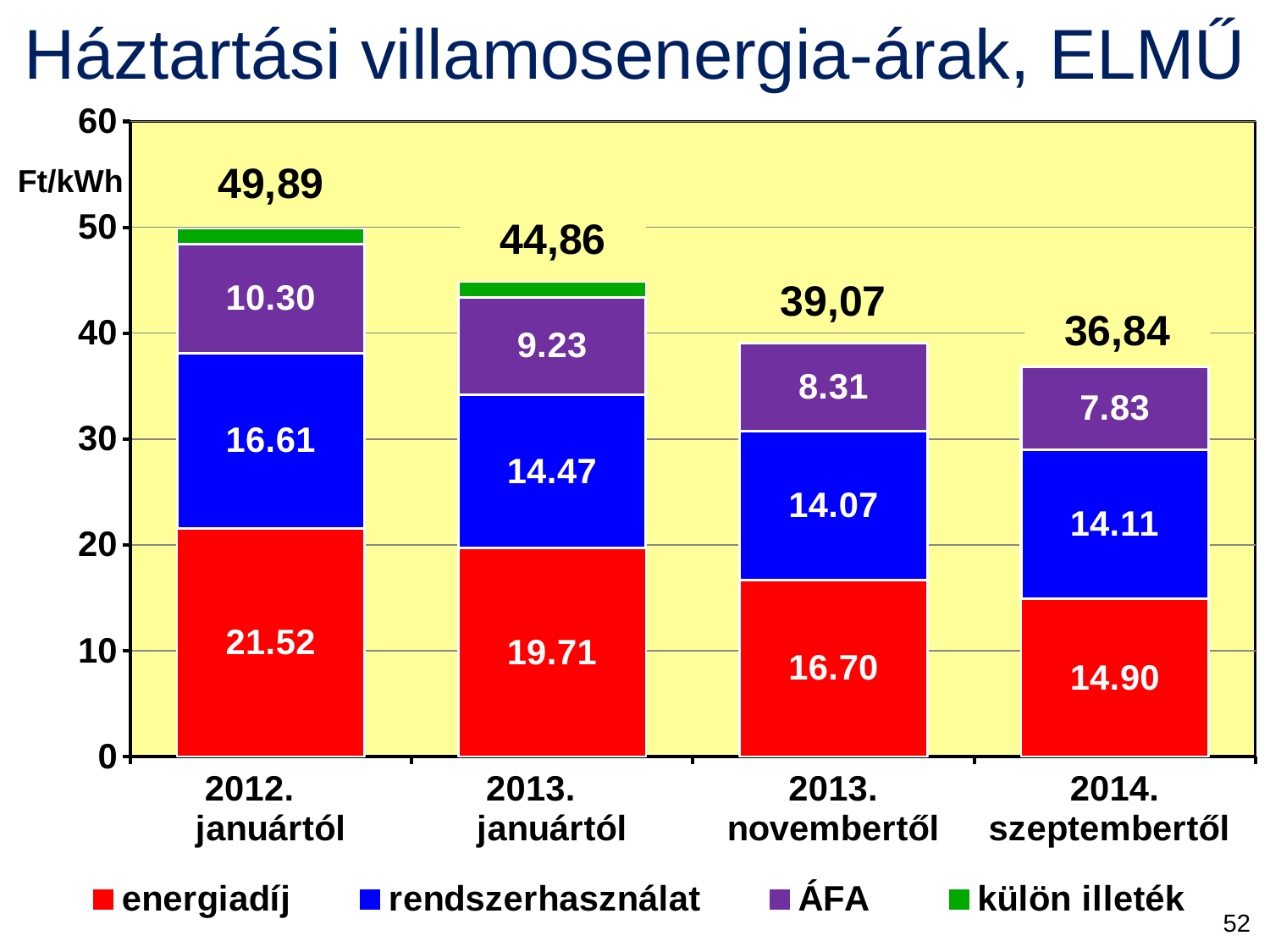
Which is larger, the rendszerhasználat value for 2012. januártól or for 2013. januártól? 2012. januártól Which period has the highest total price? 2012. januártól How many periods are shown on the x axis? 4 What is the difference between the total for 2012. januártól and the total for 2014. szeptembertől? 13,05 What is the energiadíj value for 2012. januártól? 21.52 What is the rendszerhasználat value for 2014. szeptembertől? 14.11 Which period has the lowest energiadíj value? 2014. szeptembertől Do the total prices rise or fall from 2012. januártól to 2014. szeptembertől? fall What is the difference between the energiadíj values for 2012. januártól and 2014. szeptembertől? 6.62 What is the total of the stacked bar for 2013. novembertől? 39,07 What is the ÁFA value for 2013. novembertől? 8.31 How many series does the legend list? 4